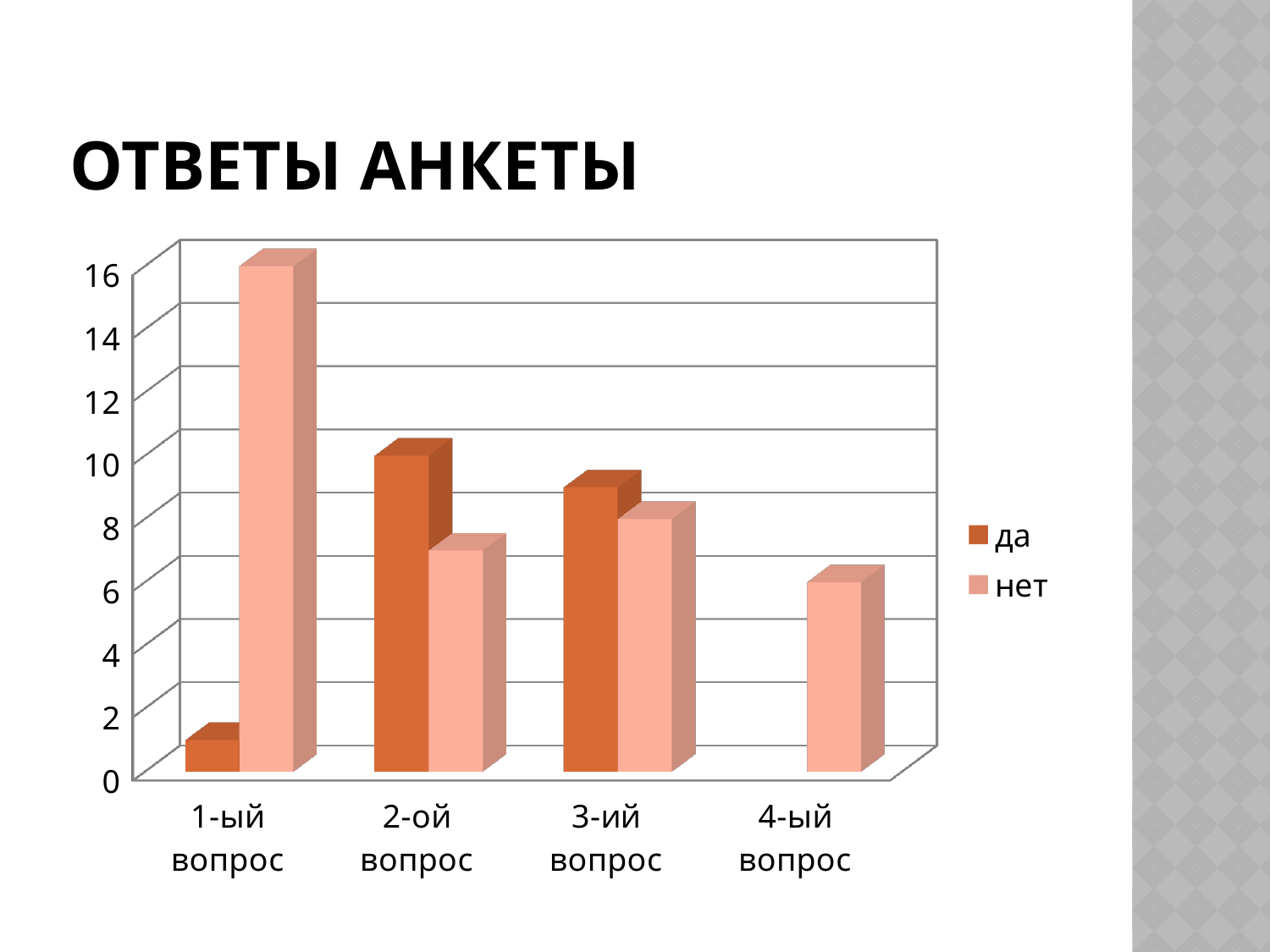
What kind of chart is shown on the slide? bar chart What is the title of the slide? ОТВЕТЫ АНКЕТЫ How many series does the legend list? 2 Which category has the highest value for the 'нет' series? 1-ый вопрос Is the 'да' value for 1-ый вопрос greater or less than 2? less How many question categories are shown on the x axis? 4 Which category has the lowest value for the 'нет' series? 4-ый вопрос For 1-ый вопрос, which is larger: 'да' or 'нет'? нет For 2-ой вопрос, which is larger: 'да' or 'нет'? да Is the 'нет' value for 1-ый вопрос greater or less than 14? greater Which category has the highest value for the 'да' series? 2-ой вопрос Is the 'нет' value for 4-ый вопрос greater or less than 8? less